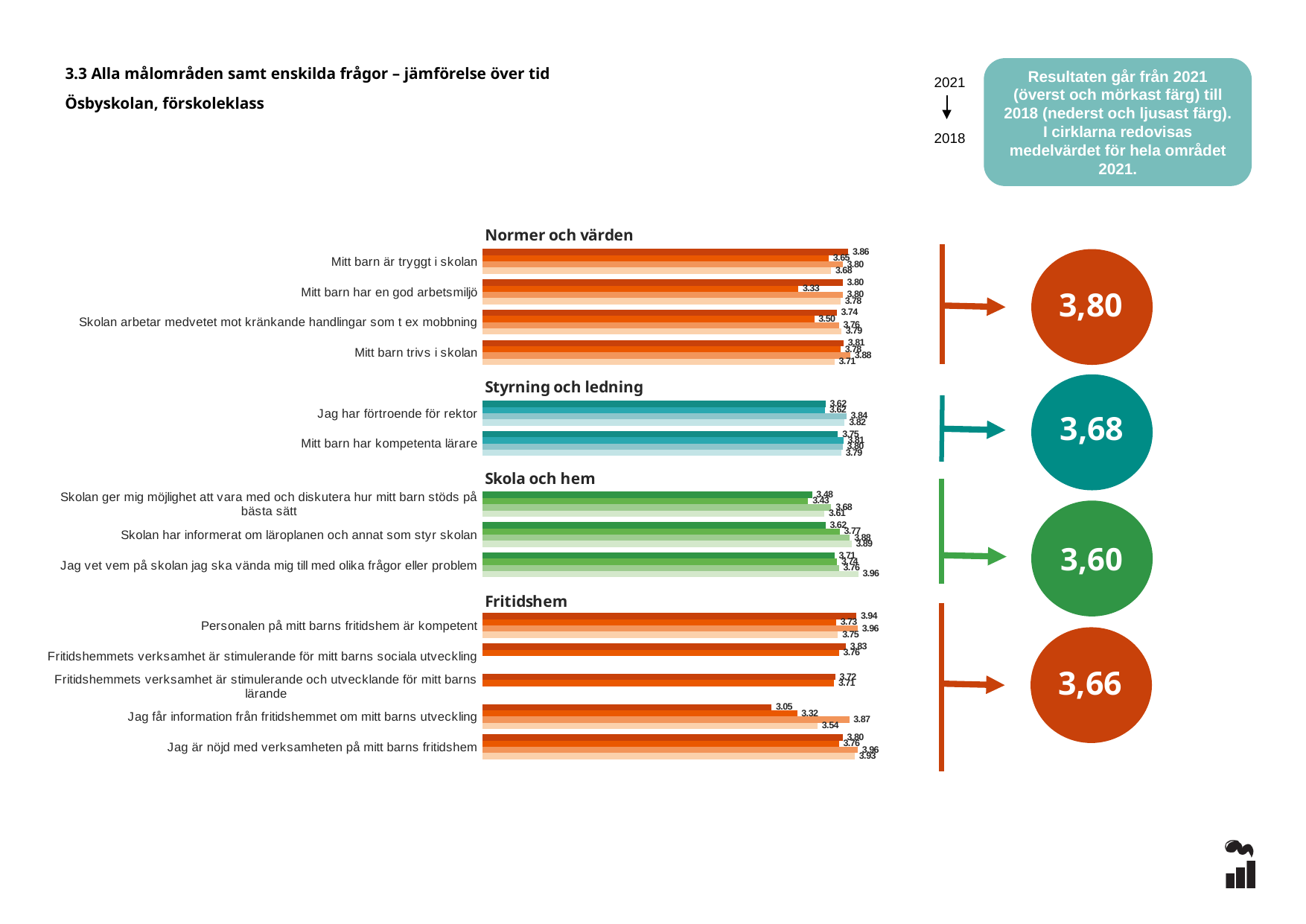
In the Fritidshem chart, which question has the highest 2021 (topmost bar) value? Personalen på mitt barns fritidshem är kompetent In the Skola och hem chart, what is the difference between the 2021 (topmost bar) values for "Jag vet vem på skolan jag ska vända mig till med olika frågor eller problem" and "Skolan ger mig möjlighet att vara med och diskutera hur mitt barn stöds på bästa sätt"? 0.23 In the Fritidshem chart, what is the 2021 (topmost bar) value for "Jag får information från fritidshemmet om mitt barns utveckling"? 3.05 How many questions (categories) are shown in the Fritidshem chart? 5 In the Normer och värden chart, what is the 2021 (topmost bar) value for "Mitt barn har en god arbetsmiljö"? 3.80 What is the 2021 mean value shown in the circle for the area Skola och hem? 3,60 In the Normer och värden chart, which has the larger 2021 (topmost bar) value: "Mitt barn är tryggt i skolan" or "Skolan arbetar medvetet mot kränkande handlingar som t ex mobbning"? Mitt barn är tryggt i skolan In the Normer och värden chart, what is the 2021 (topmost, darkest bar) value for "Mitt barn är tryggt i skolan"? 3.86 In the Fritidshem chart, which question has the lowest 2021 (topmost bar) value? Jag får information från fritidshemmet om mitt barns utveckling How many questions (categories) are shown in the Skola och hem chart? 3 In the Styrning och ledning chart, what is the 2021 (topmost bar) value for "Jag har förtroende för rektor"? 3.62 What type of chart is used to show the results for each question on the slide? Bar chart